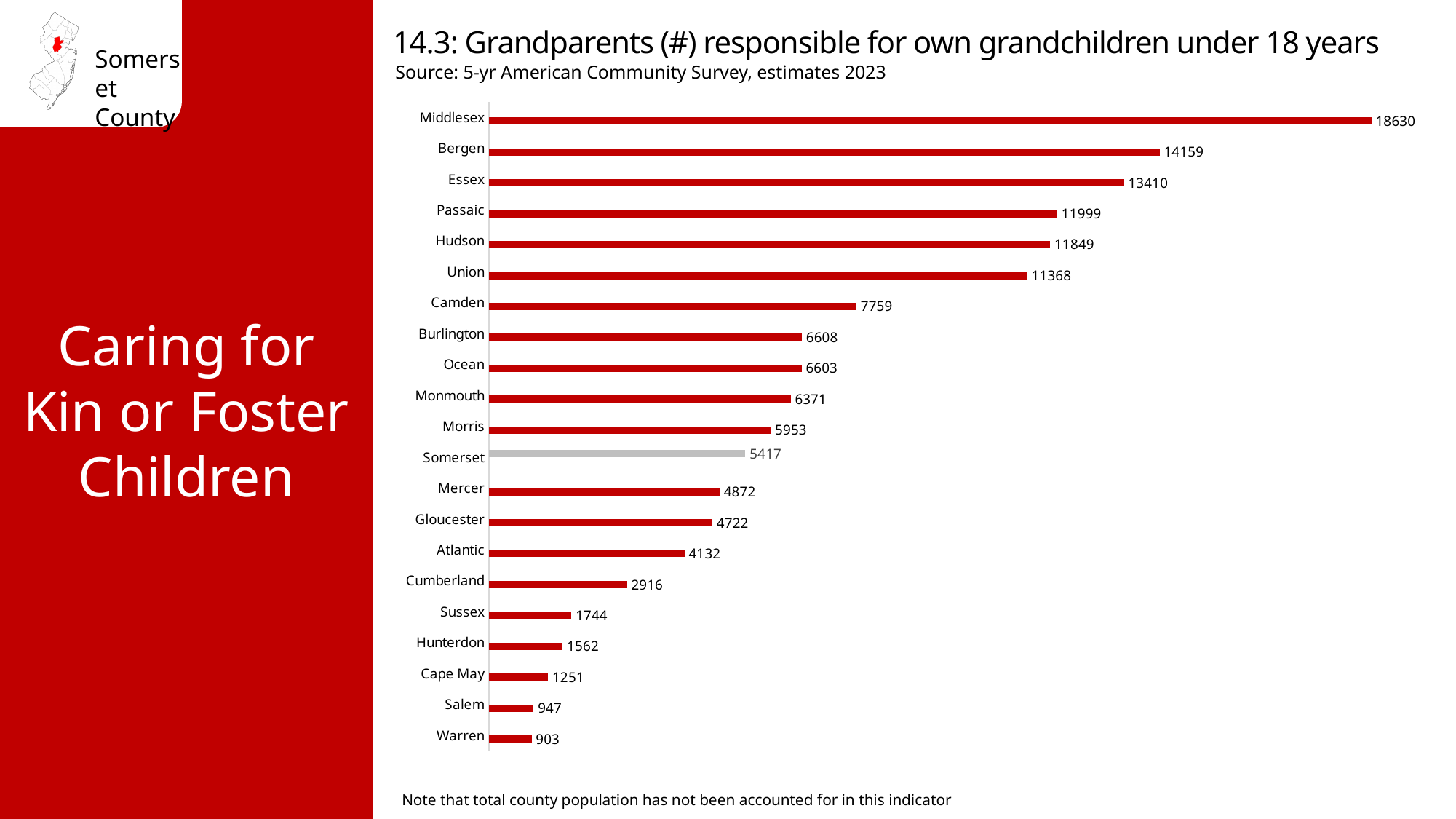
How many counties are shown in the chart? 21 Which county has the lowest value? Warren Which county has the highest value? Middlesex What kind of chart is shown on the slide? Bar chart Which is larger, the value for Camden or the value for Burlington? Camden What is the value for Middlesex? 18630 Which county's bar is coloured grey instead of red? Somerset What is the difference between the values for Bergen and Essex? 749 What is the value for Cumberland? 2916 What is the value for Somerset? 5417 Which is larger, the value for Sussex or the value for Hunterdon? Sussex What is the difference between the values for Somerset and Mercer? 545